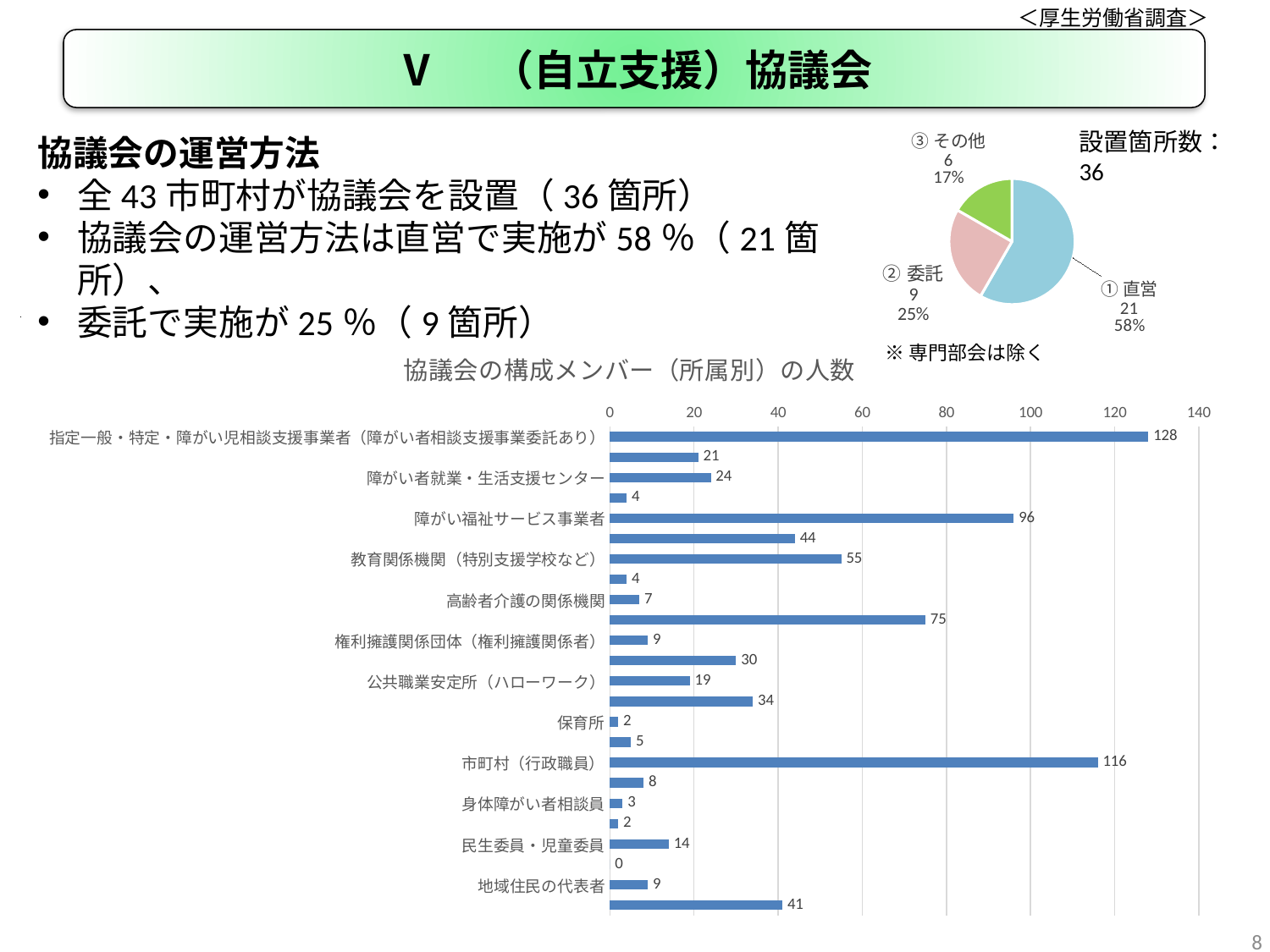
In the pie chart at the top right, what percentage share does ① 直営 have? 58% In the pie chart at the top right, which slice is the largest? ① 直営 In the chart 協議会の構成メンバー（所属別）の人数, which category has the highest value? 指定一般・特定・障がい児相談支援事業者（障がい者相談支援事業委託あり） What kind of chart is the chart at the top right of the slide? Pie chart In the chart 協議会の構成メンバー（所属別）の人数, what is the value for 障がい福祉サービス事業者? 96 In the pie chart at the top right, what is the value for ② 委託? 9 In the chart 協議会の構成メンバー（所属別）の人数, what is the value for 保育所? 2 In the chart 協議会の構成メンバー（所属別）の人数, what is the difference between the value for 指定一般・特定・障がい児相談支援事業者（障がい者相談支援事業委託あり） and the value for 市町村（行政職員）? 12 In the chart 協議会の構成メンバー（所属別）の人数, what is the value for 市町村（行政職員）? 116 In the chart 協議会の構成メンバー（所属別）の人数, which is larger: the value for 教育関係機関（特別支援学校など） or the value for 障がい者就業・生活支援センター? 教育関係機関（特別支援学校など） In the pie chart at the top right, what percentage share does ③ その他 have? 17% In the pie chart at the top right, how many slices are there? 3